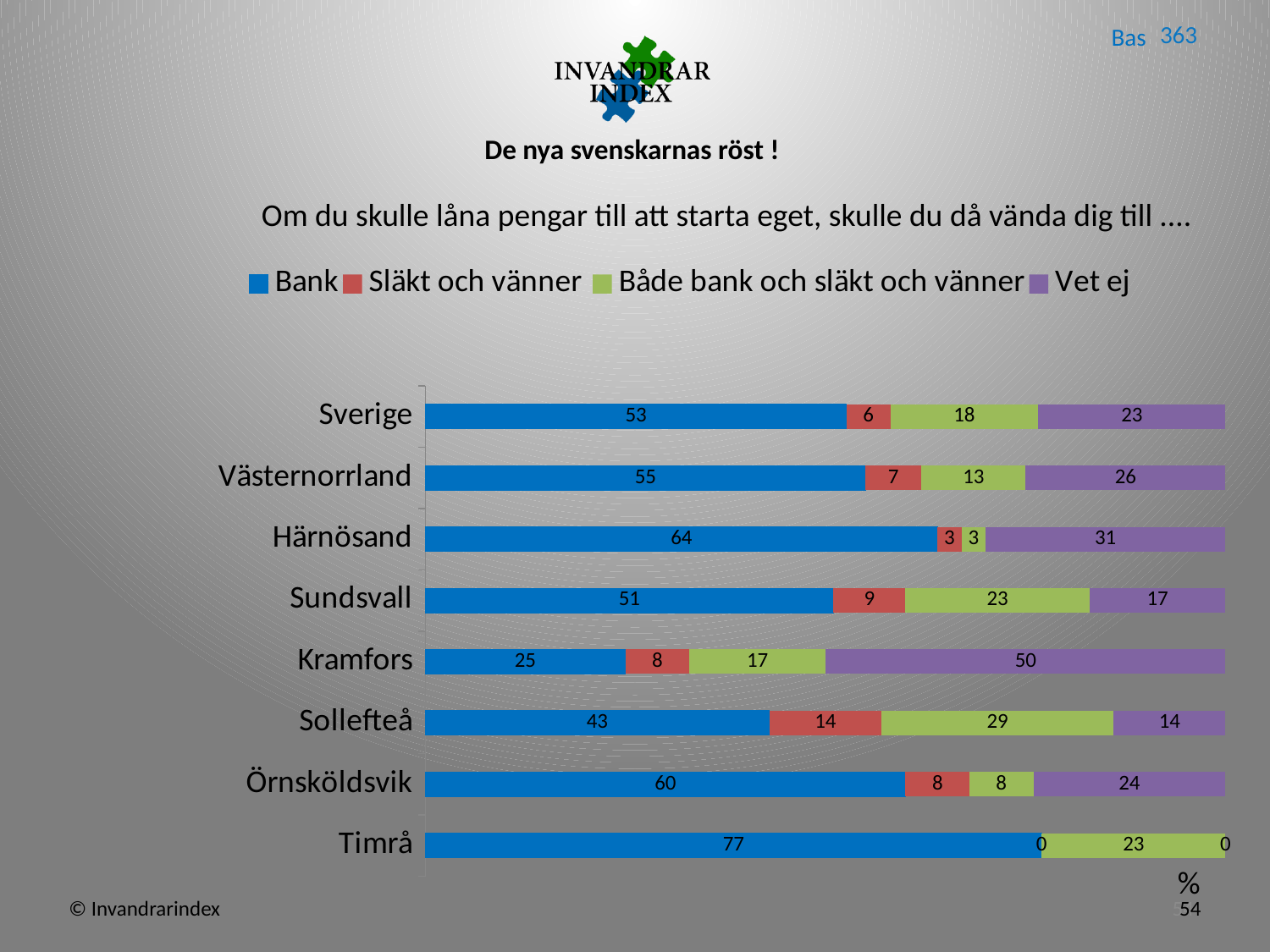
What is the value for Både bank och släkt och vänner for Härnösand? 3 How many categories (regions) are shown on the chart? 8 What kind of chart is shown on the slide? Stacked bar chart Which is larger: the Vet ej value for Västernorrland or the Vet ej value for Örnsköldsvik? Västernorrland What is the value for Bank for Timrå? 77 Which region has the highest value for Bank? Timrå What is the value for Släkt och vänner for Sollefteå? 14 Which region has the lowest value for Bank? Kramfors What is the value for Vet ej for Kramfors? 50 How many series does the legend list? 4 What is the difference between the Bank value for Härnösand and the Bank value for Sundsvall? 13 What is the total of the stacked bar for Sollefteå? 100